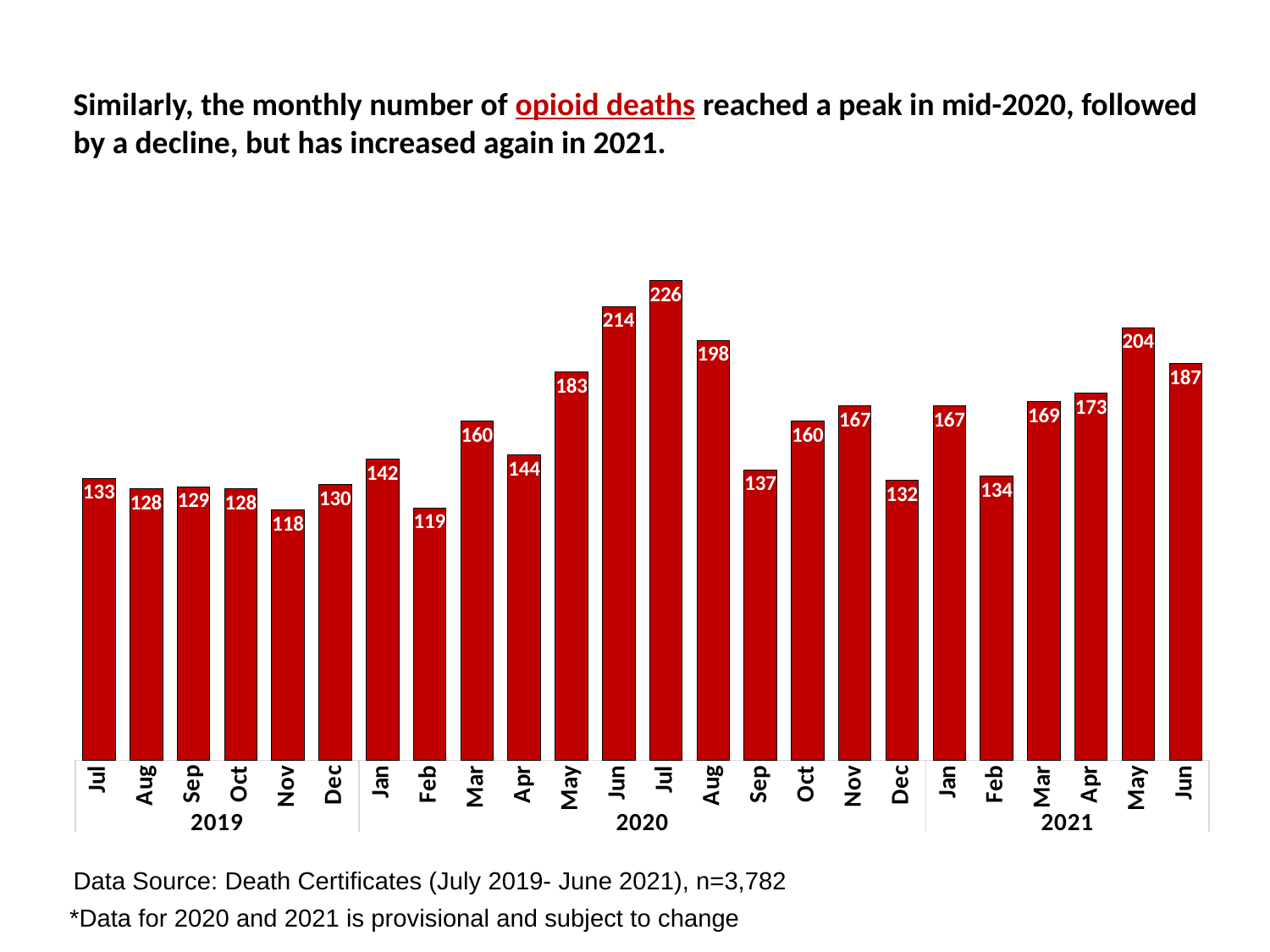
How many monthly bars are shown in the chart? 24 Which month has the highest number of opioid deaths? Jul 2020 Which is larger, the number of opioid deaths in June 2020 or August 2020? June 2020 What is the number of opioid deaths in February 2020? 119 What is the difference between the number of opioid deaths in May 2021 and May 2020? 21 What is the number of opioid deaths in May 2021? 204 Do the values rise or fall from February 2020 to July 2020? Rise What is the number of opioid deaths in November 2019? 118 Which month has the lowest number of opioid deaths? Nov 2019 What is the difference between the number of opioid deaths in July 2020 and June 2021? 39 What type of chart is shown on the slide? Bar chart What is the number of opioid deaths in July 2020? 226